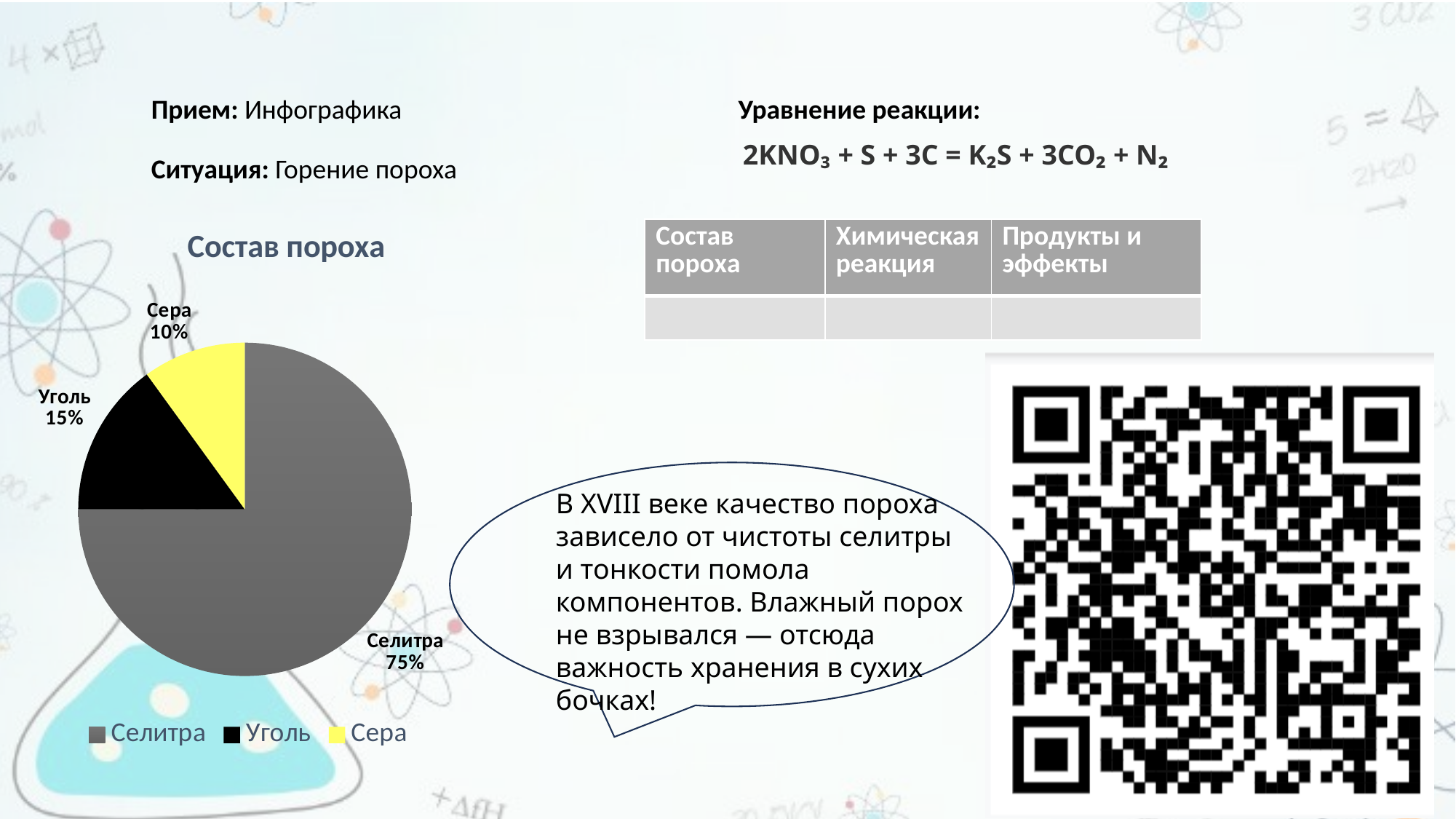
What is the difference in percentage points between Селитра and Уголь? 60 Which is larger in the pie chart, Уголь or Сера? Уголь Which component has the largest slice in the pie chart? Селитра What is the share of Уголь in the pie chart? 15% What is the share of Селитра in the pie chart? 75% What is the title of the pie chart? Состав пороха What type of chart is shown under the title "Состав пороха"? pie chart What colour is the Сера slice in the pie chart? yellow What is the share of Сера in the pie chart? 10% How many entries does the legend of the pie chart list? 3 How many slices does the pie chart have? 3 Which component has the smallest slice in the pie chart? Сера